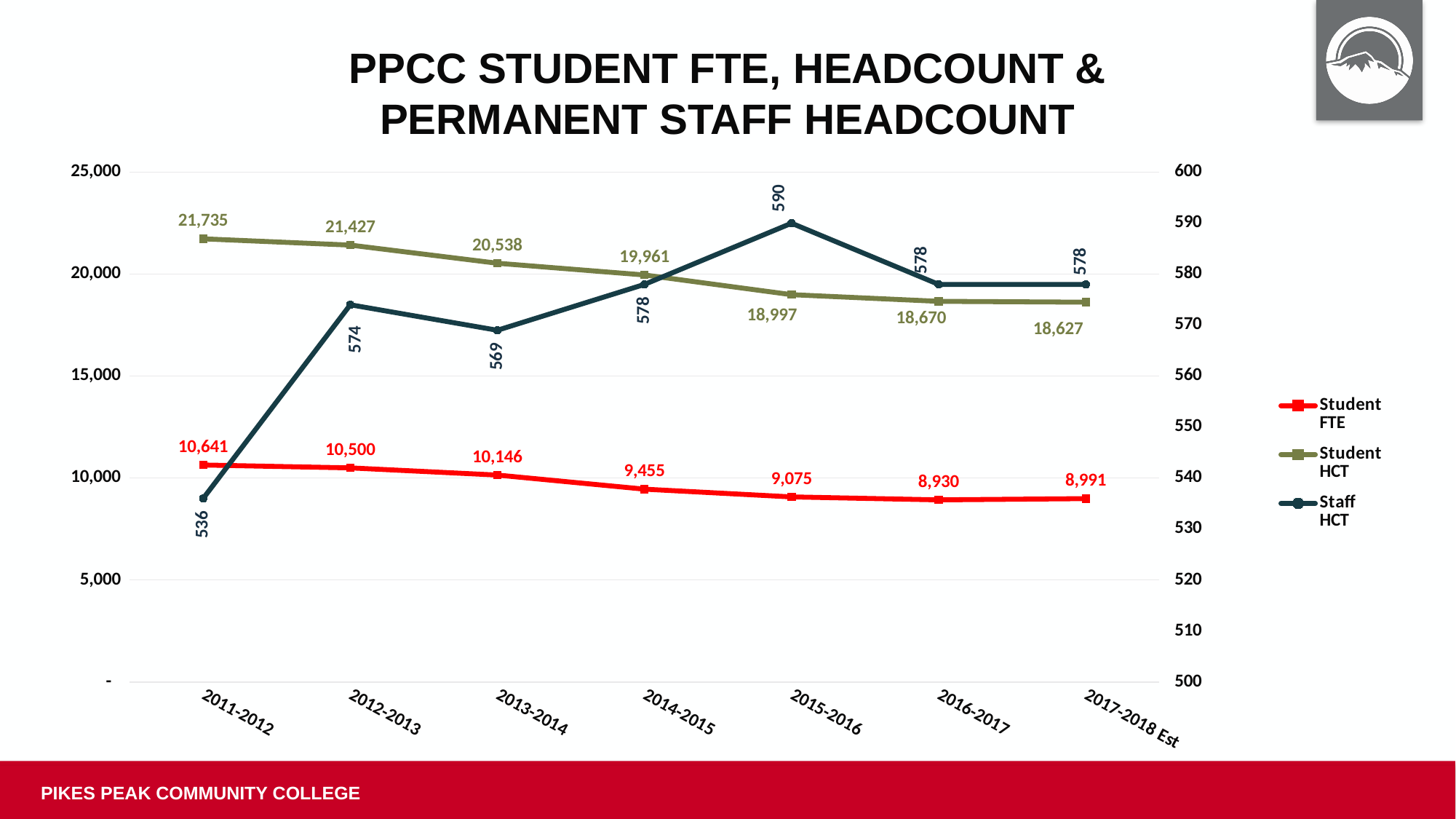
How many academic years are shown on the x axis? 7 What is the Staff HCT value for 2015-2016? 590 Does Student HCT rise or fall from 2011-2012 to 2017-2018 Est? fall How many series does the legend list? 3 What is the difference between Student HCT in 2011-2012 and 2017-2018 Est? 3,108 Which is larger, Student FTE in 2012-2013 or Student FTE in 2013-2014? 2012-2013 What kind of chart is shown on the slide? line chart What is the Student HCT value for 2011-2012? 21,735 In which year is Student FTE lowest? 2016-2017 Is the Student HCT value for 2015-2016 greater or less than 20,000? less What is the Student FTE value for 2014-2015? 9,455 In which year is Staff HCT highest? 2015-2016